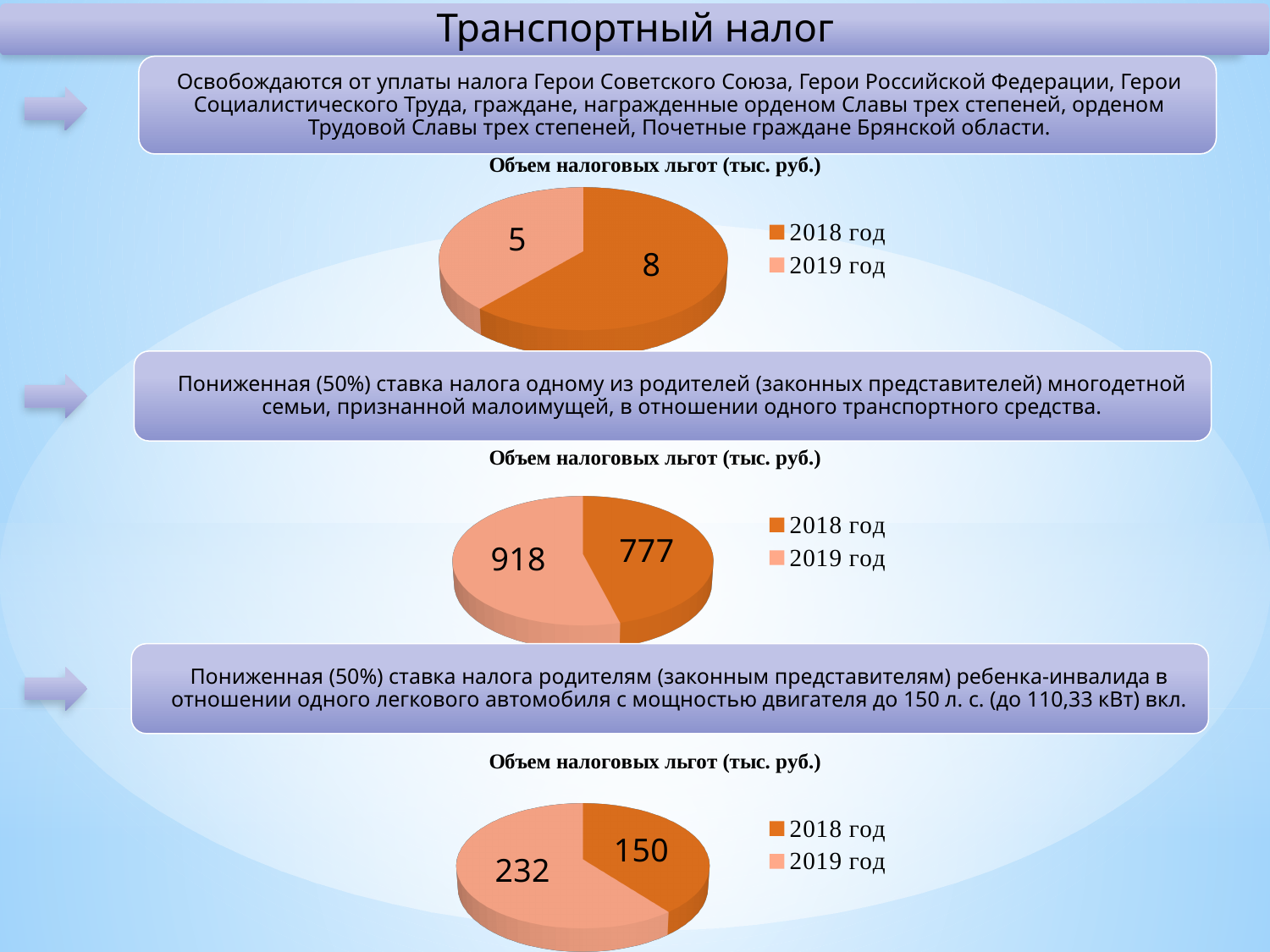
In the bottom pie chart, what is the value for 2019 год? 232 In the middle pie chart, what is the value for 2018 год? 777 How many series does the legend of the top pie chart list? 2 In the middle pie chart, what is the difference between the 2019 год and 2018 год values? 141 In the top pie chart, what is the value for 2019 год? 5 In the bottom pie chart, what is the value for 2018 год? 150 In the top pie chart, what is the value for 2018 год? 8 In the top pie chart, which year has the smaller value? 2019 год In the middle pie chart, what is the value for 2019 год? 918 In the bottom pie chart, what is the difference between the 2019 год and 2018 год values? 82 What type of chart is the bottom chart on the slide? Pie chart In the middle pie chart, which year has the larger value? 2019 год